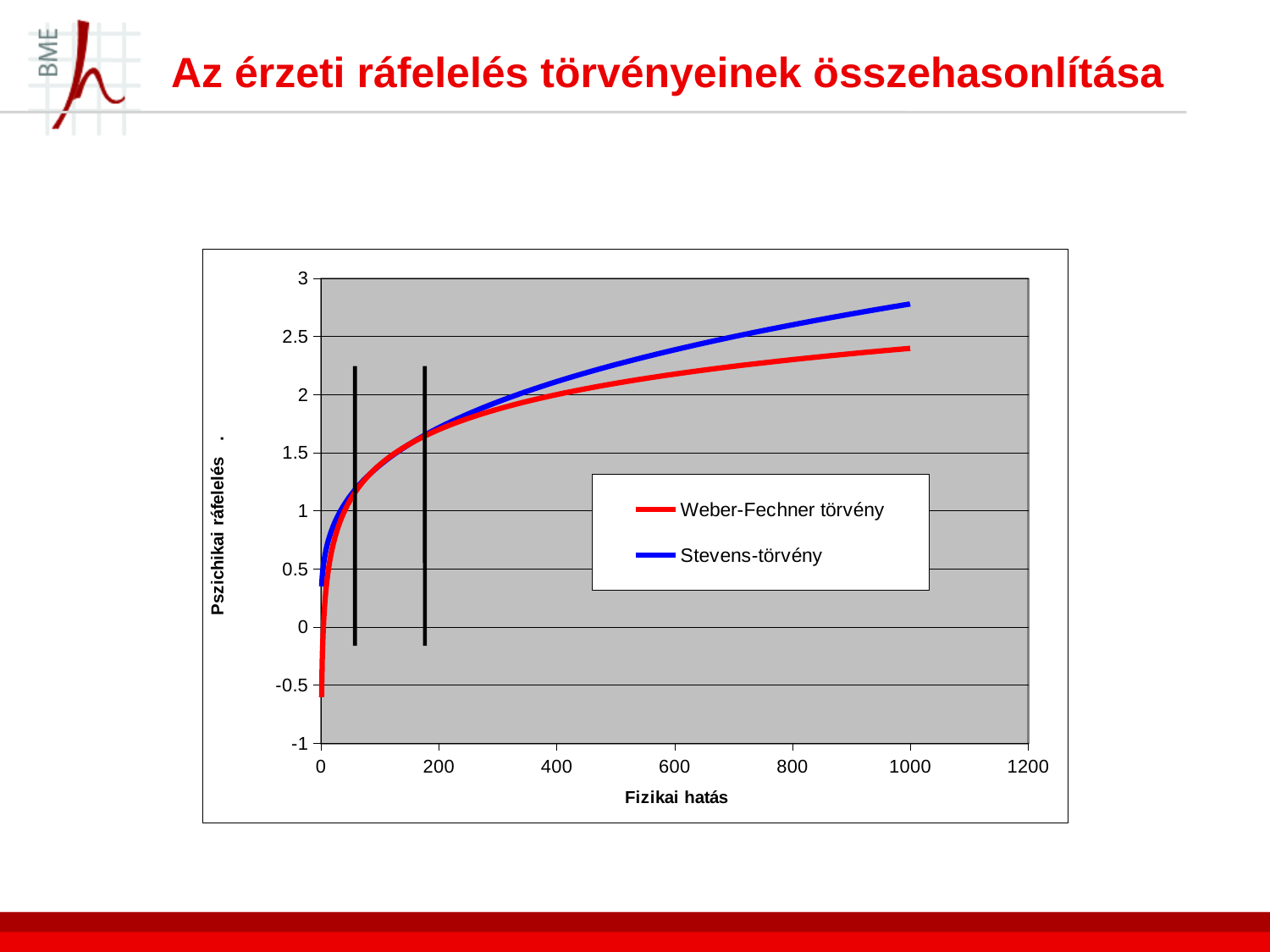
How many series does the legend list? 2 Is the value of the Weber-Fechner törvény series at Fizikai hatás = 1000 greater or less than 2.5? less Is the value of the Weber-Fechner törvény series at Fizikai hatás = 200 greater or less than 1? greater What is the title of the x axis? Fizikai hatás Is the value of the Stevens-törvény series at Fizikai hatás = 1000 greater or less than 2.5? greater What kind of chart is shown on the slide? line chart Do the values of the Weber-Fechner törvény series rise or fall as Fizikai hatás increases? rise What are the two series named in the legend? Weber-Fechner törvény and Stevens-törvény At Fizikai hatás = 1000, which series has the higher value, Weber-Fechner törvény or Stevens-törvény? Stevens-törvény Do the values of the Stevens-törvény series rise or fall as Fizikai hatás increases? rise